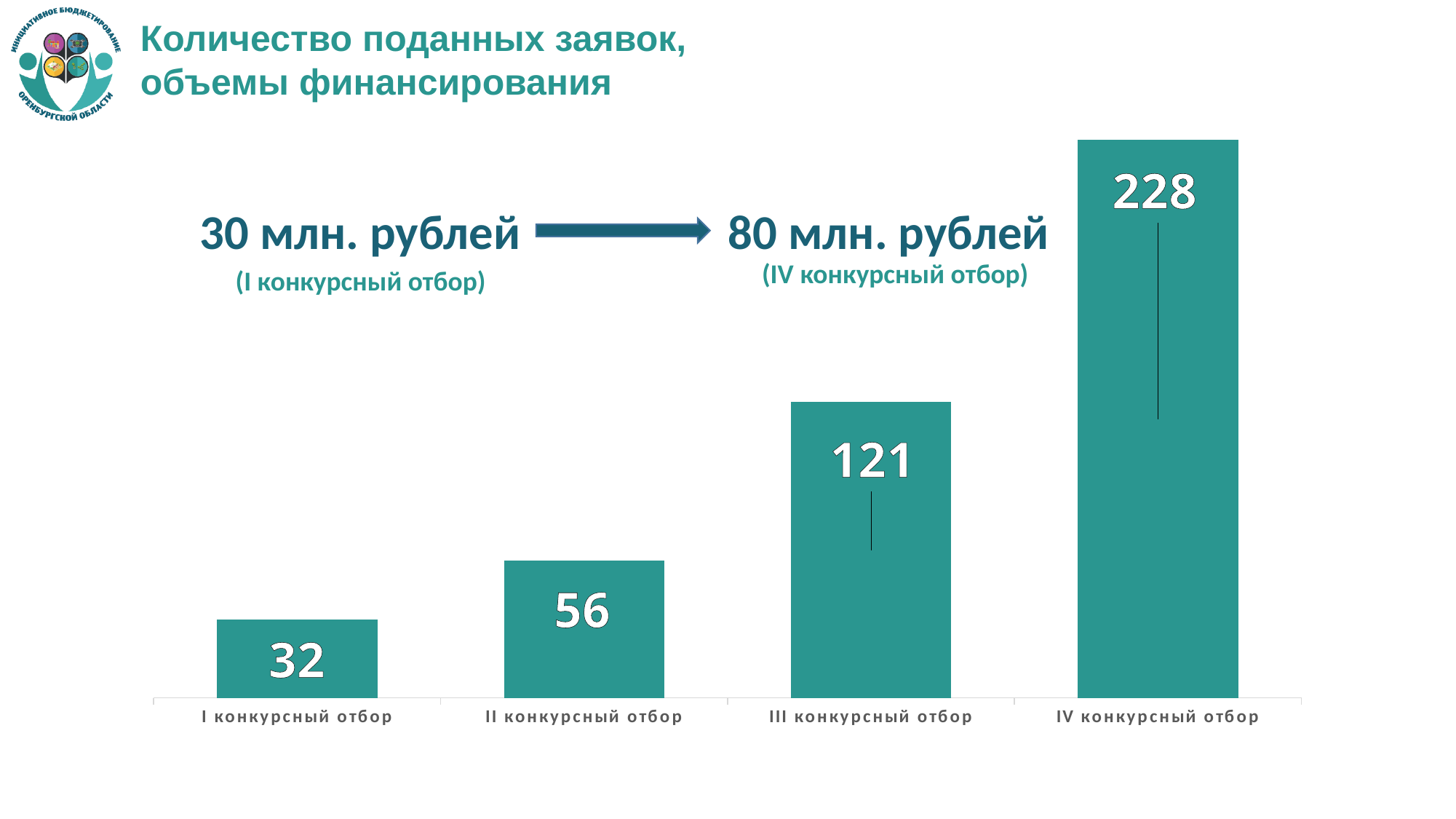
What is the value for II конкурсный отбор? 56 Which is larger, the value for II конкурсный отбор or the value for III конкурсный отбор? III конкурсный отбор Do the values rise or fall from I конкурсный отбор to IV конкурсный отбор? rise What is the value for III конкурсный отбор? 121 What is the value for I конкурсный отбор? 32 How many categories are shown in the bar chart? 4 What is the difference between the values for IV конкурсный отбор and III конкурсный отбор? 107 Which category has the lowest value? I конкурсный отбор What is the difference between the values for II конкурсный отбор and I конкурсный отбор? 24 What is the value for IV конкурсный отбор? 228 Which category has the highest value? IV конкурсный отбор What kind of chart is shown on the slide? bar chart